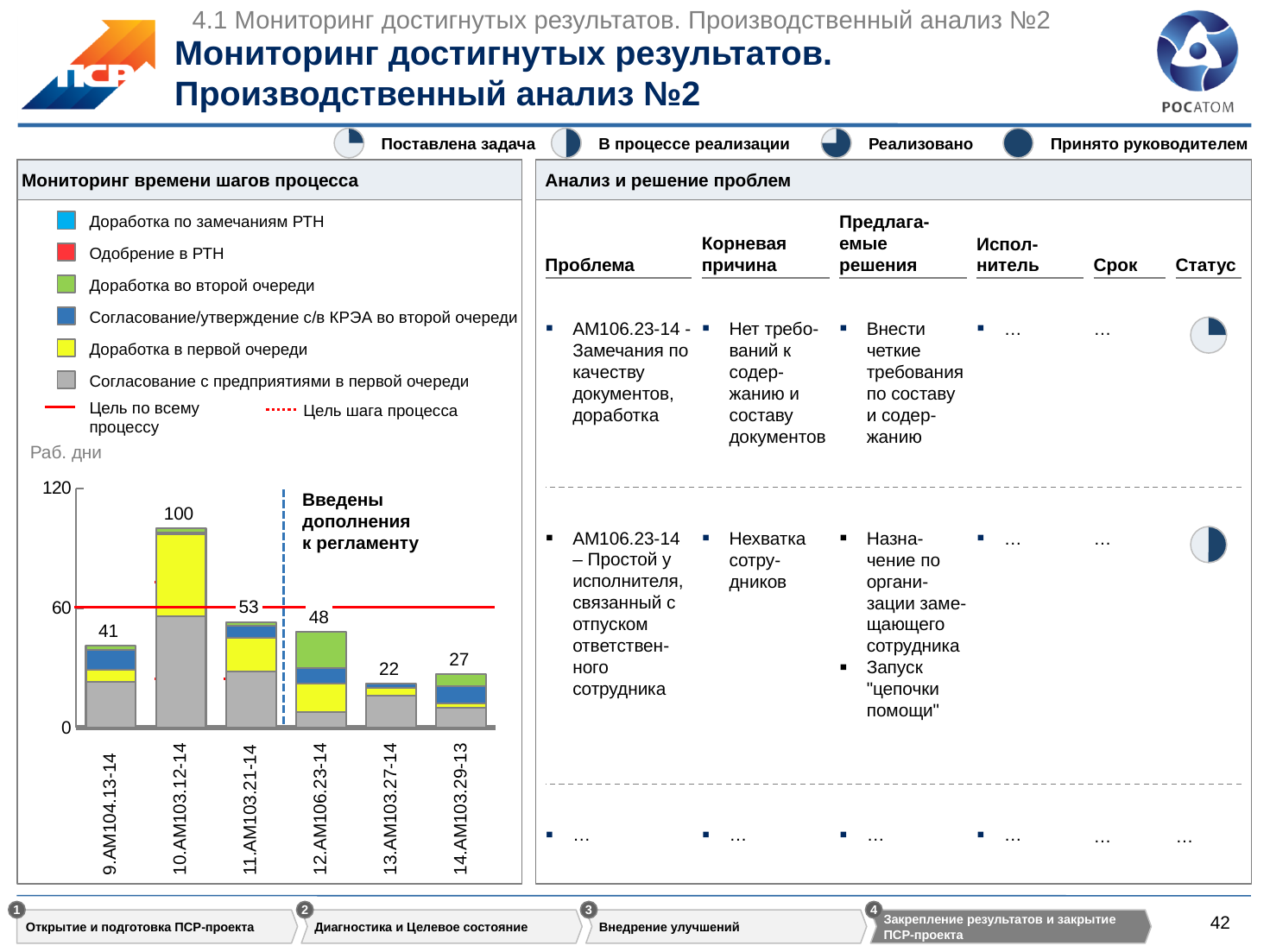
What is the difference between the totals for 10.АМ103.12-14 and 11.АМ103.21-14? 47 What is the total value shown for 10.АМ103.12-14? 100 Is the total for 11.АМ103.21-14 greater or less than 60? less How many stacked bar series does the legend list (excluding the target lines)? 6 What is the total value shown for 13.АМ103.27-14? 22 What type of chart is shown? stacked bar chart Which category has the lowest total? 13.АМ103.27-14 What is the unit label shown above the y axis? Раб. дни Which category has the highest total? 10.АМ103.12-14 How many categories are shown on the x axis? 6 Which is larger, the total for 9.АМ104.13-14 or the total for 14.АМ103.29-13? 9.АМ104.13-14 What is the total value shown for 12.АМ106.23-14? 48